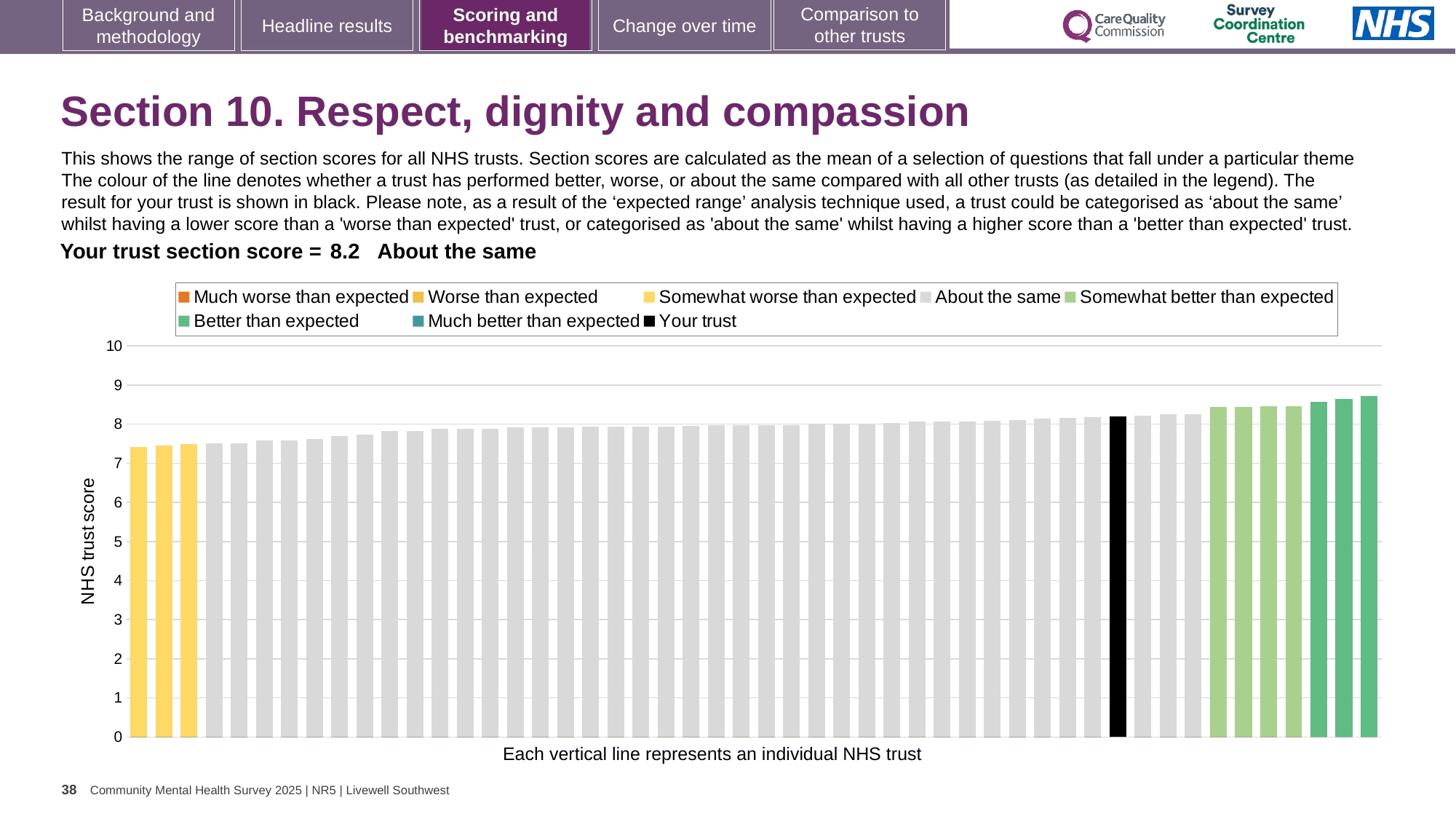
How many entries does the chart legend list? 8 Which is larger: the value of the 'Your trust' bar or the value of the leftmost bar? Your trust How many bars are coloured as 'Somewhat worse than expected' (yellow)? 3 What kind of chart is shown on the slide? Bar chart Do the bar values rise or fall from left to right along the x axis? Rise What is the label on the vertical axis of the chart? NHS trust score How many bars are coloured as 'Better than expected' (darker green)? 3 Which legend category does the highest bar in the chart belong to? Better than expected Is the value of the black 'Your trust' bar greater or less than 8? greater What is the section score for your trust shown on the slide? 8.2 Is the value of the lowest bar in the chart greater or less than 8? less Is the value of the highest bar in the chart greater or less than 9? less